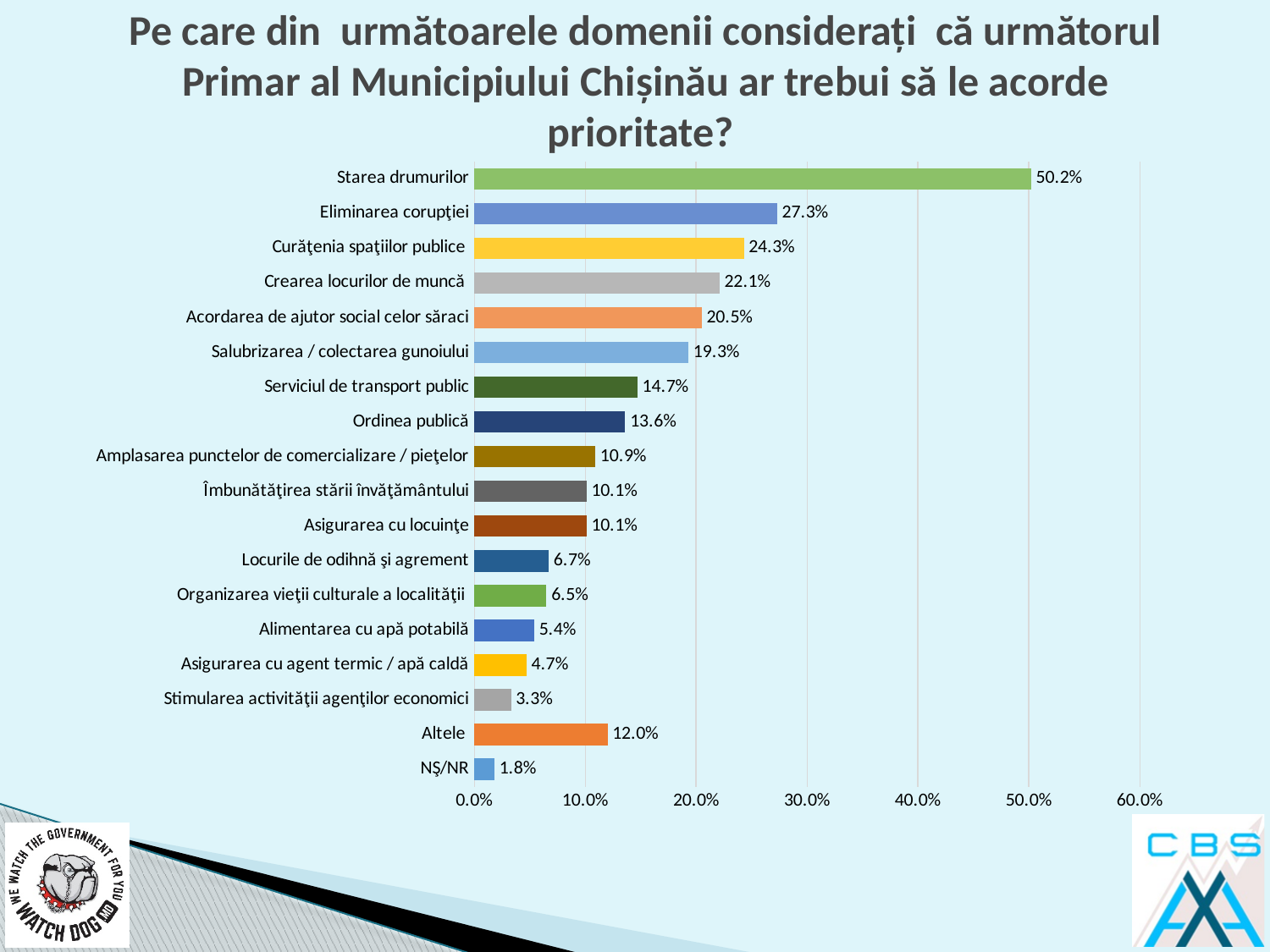
Is the value for Crearea locurilor de muncă greater or less than 20.0%? greater What is the value for Eliminarea corupţiei? 27.3% Which is larger, Serviciul de transport public or Ordinea publică? Serviciul de transport public How many categories are shown in the chart? 18 Which category has the lowest value? NŞ/NR What is the value for Starea drumurilor? 50.2% What is the difference between Altele and Stimularea activităţii agenţilor economici? 8.7% What is the difference between Starea drumurilor and Eliminarea corupţiei? 22.9% Which category has the highest value? Starea drumurilor What is the value for Altele? 12.0% What kind of chart is shown on the slide? bar chart What is the value for Asigurarea cu agent termic / apă caldă? 4.7%